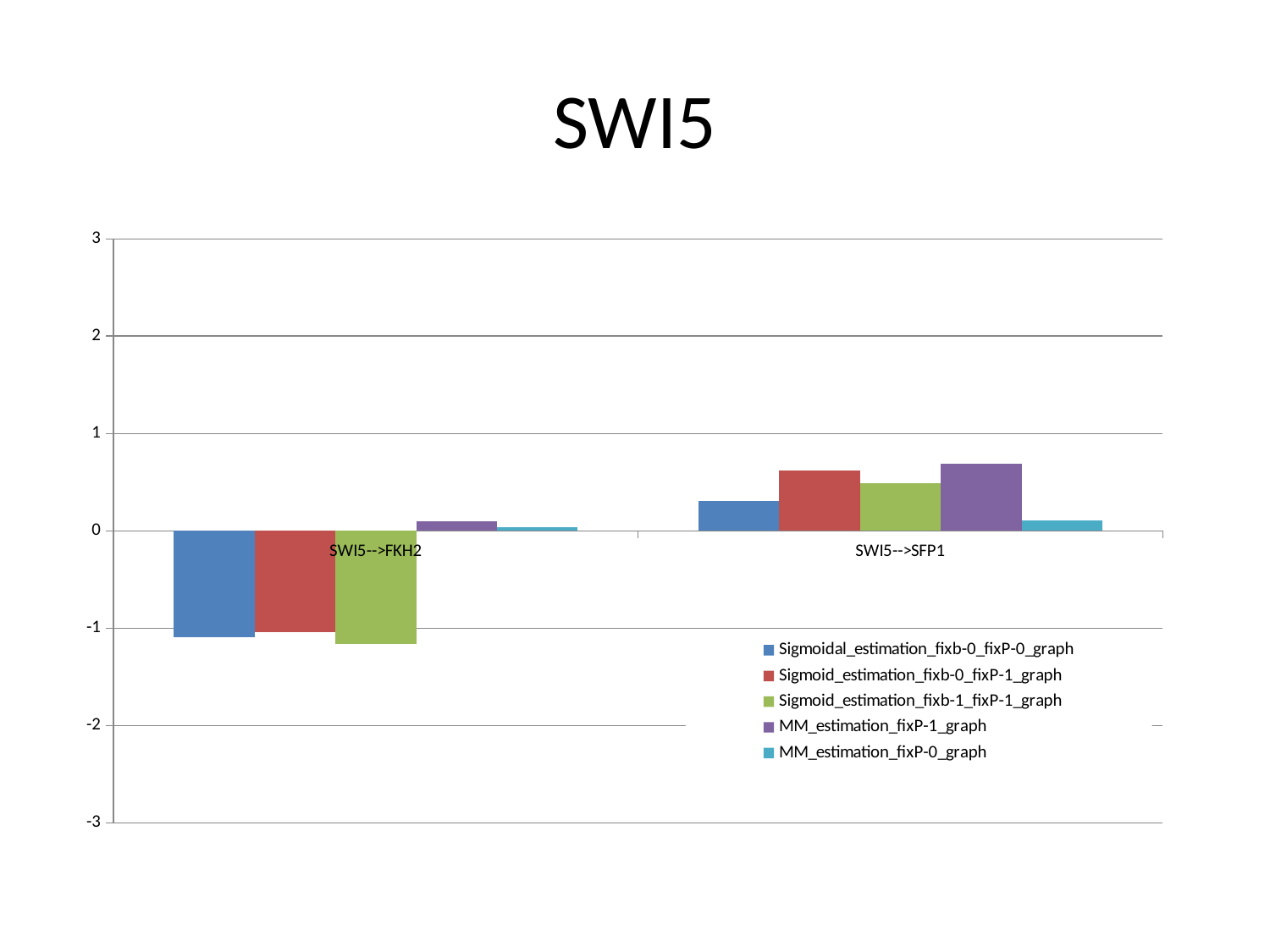
Is the value of Sigmoidal_estimation_fixb-0_fixP-0_graph for SWI5-->FKH2 greater or less than 0? less What kind of chart is shown on the slide? bar chart Is the value of MM_estimation_fixP-1_graph for SWI5-->SFP1 greater or less than 1? less Is the value of Sigmoid_estimation_fixb-1_fixP-1_graph for SWI5-->SFP1 greater or less than 0? greater How many categories are shown on the x axis? 2 For SWI5-->SFP1, which series has the lowest value? MM_estimation_fixP-0_graph Which colour represents MM_estimation_fixP-0_graph in the legend? light blue For SWI5-->FKH2, which is larger: MM_estimation_fixP-1_graph or Sigmoid_estimation_fixb-0_fixP-1_graph? MM_estimation_fixP-1_graph For SWI5-->SFP1, which is larger: MM_estimation_fixP-1_graph or MM_estimation_fixP-0_graph? MM_estimation_fixP-1_graph How many series does the legend list? 5 What is the title of the chart? SWI5 Does the value of Sigmoidal_estimation_fixb-0_fixP-0_graph rise or fall from SWI5-->FKH2 to SWI5-->SFP1? rise